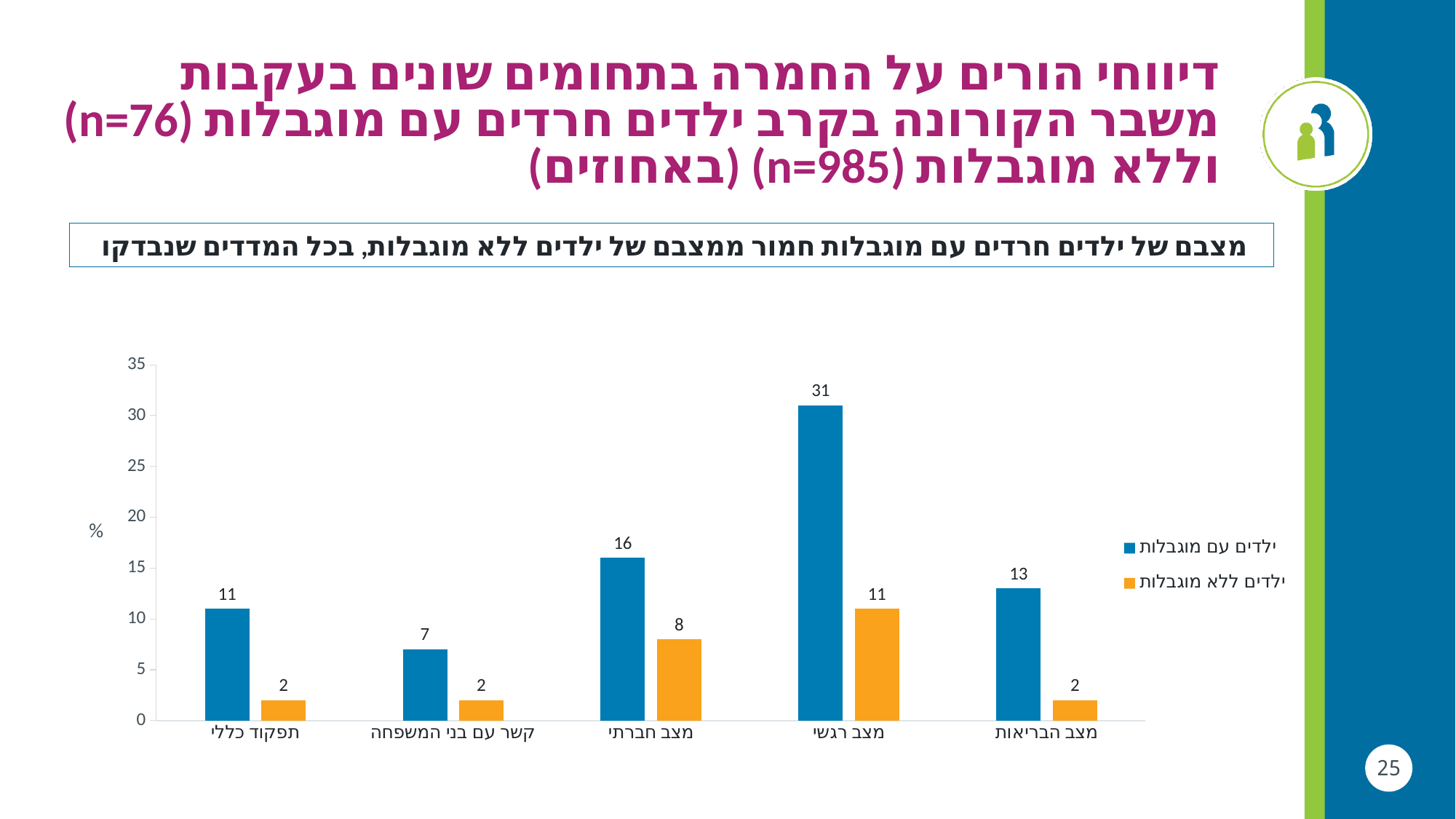
What is the difference between the ילדים עם מוגבלות and ילדים ללא מוגבלות values in the מצב רגשי category? 20 Which category has the lowest value for ילדים עם מוגבלות? קשר עם בני המשפחה What is the value for ילדים עם מוגבלות in the קשר עם בני המשפחה category? 7 What type of chart is shown on the slide? bar chart Which is larger: the ילדים עם מוגבלות value for תפקוד כללי or for מצב הבריאות? מצב הבריאות How many series does the chart legend list? 2 Which category has the highest value for ילדים עם מוגבלות? מצב רגשי What is the value for ילדים ללא מוגבלות in the מצב חברתי category? 8 What is the value for ילדים עם מוגבלות in the מצב רגשי category? 31 What is the difference between the ילדים עם מוגבלות and ילדים ללא מוגבלות values in the מצב הבריאות category? 11 Is the value for ילדים עם מוגבלות in מצב רגשי greater or less than 30? greater How many categories are shown on the x axis of the chart? 5